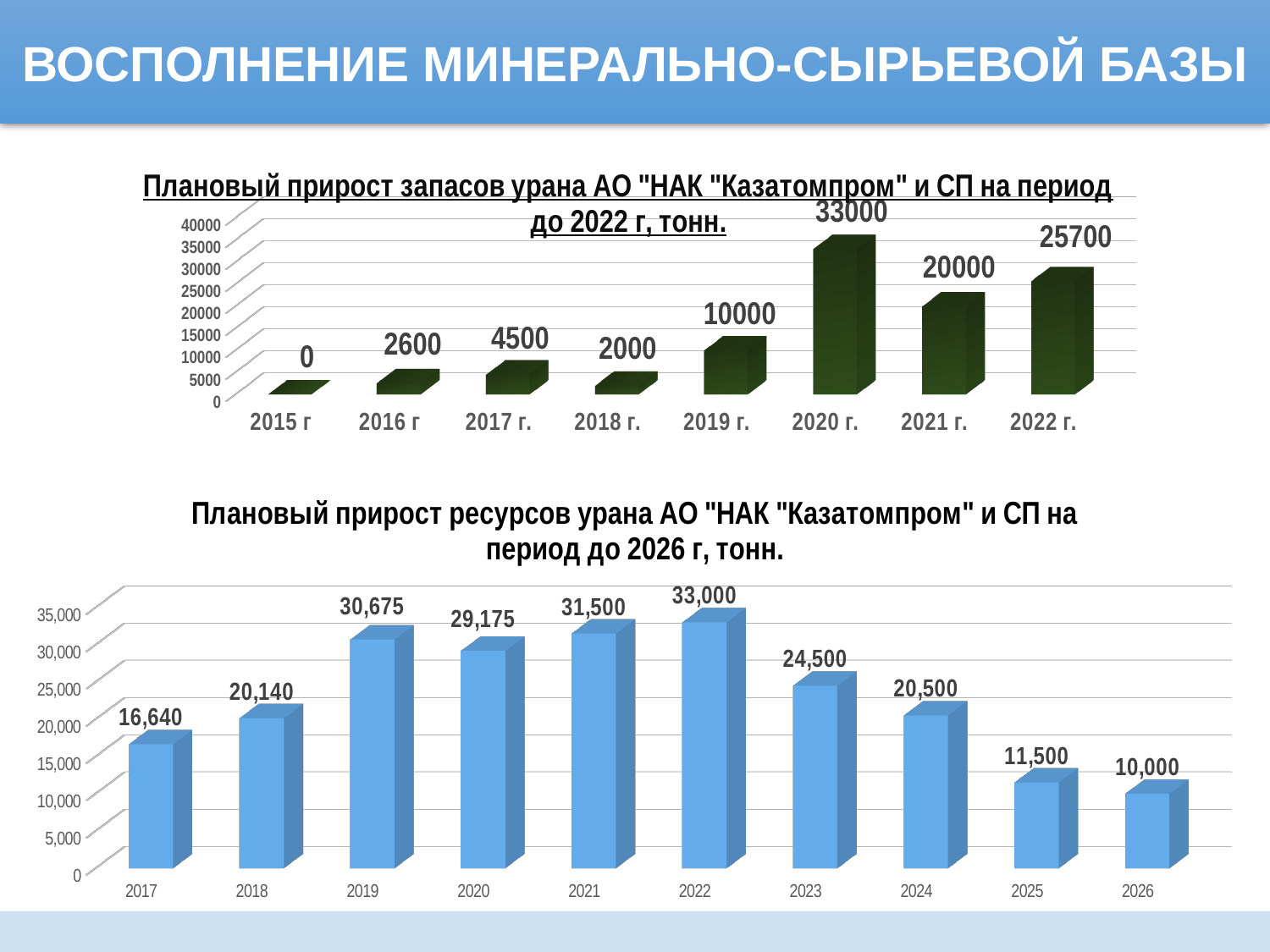
In the top chart, which year has the lowest value? 2015 г In the top chart, which year has the highest value? 2020 г. In the top chart, what is the difference between the values for 2022 г. and 2021 г.? 5700 In the top chart, what is the value for 2020 г.? 33000 In the top chart, what is the value for 2017 г.? 4500 In the top chart, how many years are shown on the x axis? 8 In the bottom chart, what is the value for 2019? 30,675 In the bottom chart, which year has the highest value? 2022 In the bottom chart, what is the value for 2024? 20,500 What kind of chart is the bottom chart? Bar chart In the bottom chart, what is the difference between the values for 2018 and 2017? 3,500 In the bottom chart, which is larger, the value for 2020 or the value for 2021? 2021